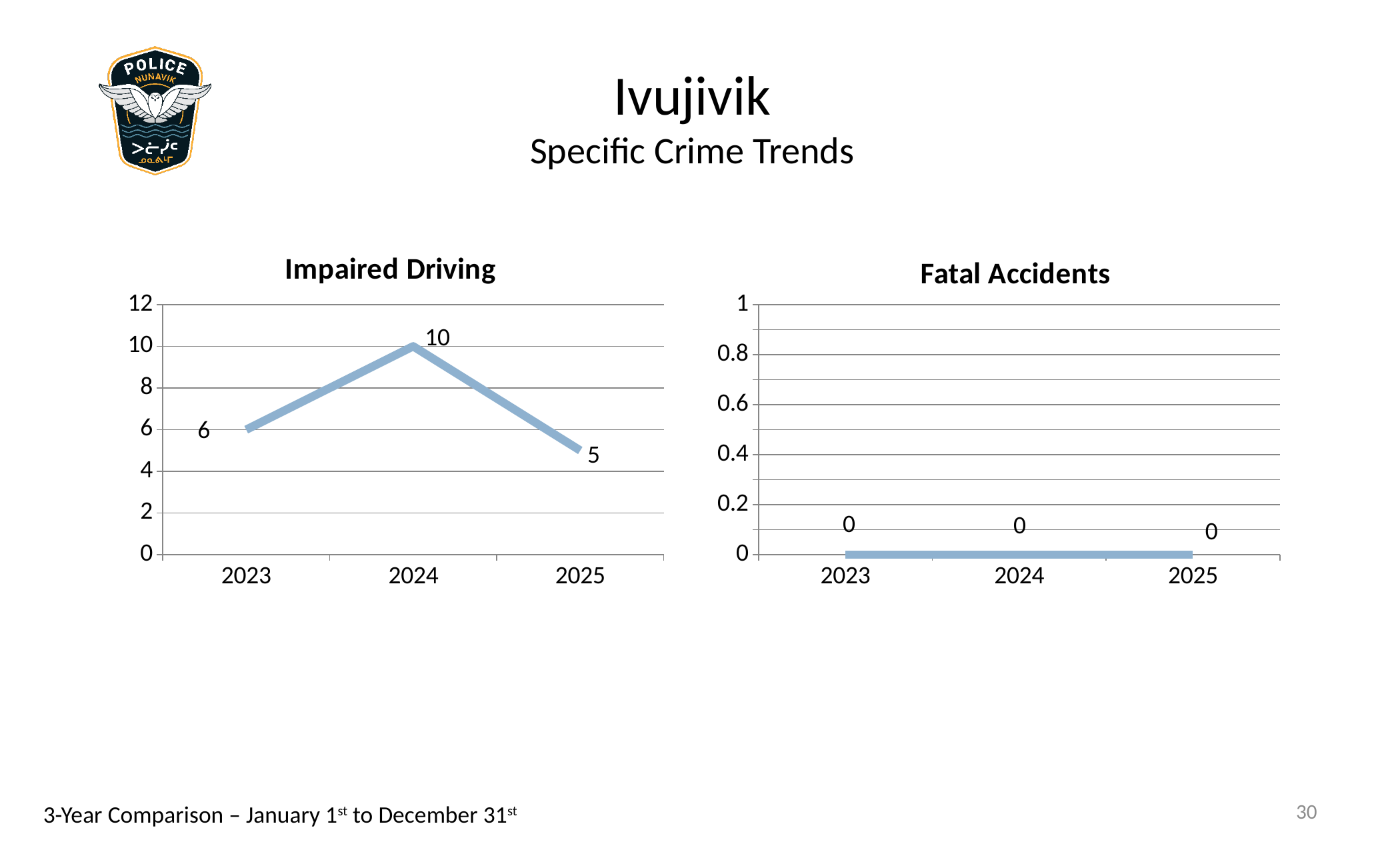
In the Impaired Driving chart, what is the value for 2023? 6 In the Fatal Accidents chart, what is the value for 2024? 0 In the Impaired Driving chart, which year has the highest value? 2024 In the Impaired Driving chart, what is the difference between the 2024 and 2025 values? 5 How many years are plotted in the Fatal Accidents chart? 3 In the Impaired Driving chart, does the value fall or rise from 2024 to 2025? fall What is the title of the chart on the right side of the slide? Fatal Accidents What kind of chart is the Impaired Driving chart? line chart In the Impaired Driving chart, which is larger, the value for 2023 or the value for 2025? 2023 In the Impaired Driving chart, which year has the lowest value? 2025 In the Impaired Driving chart, what is the value for 2024? 10 In the Impaired Driving chart, what is the value for 2025? 5